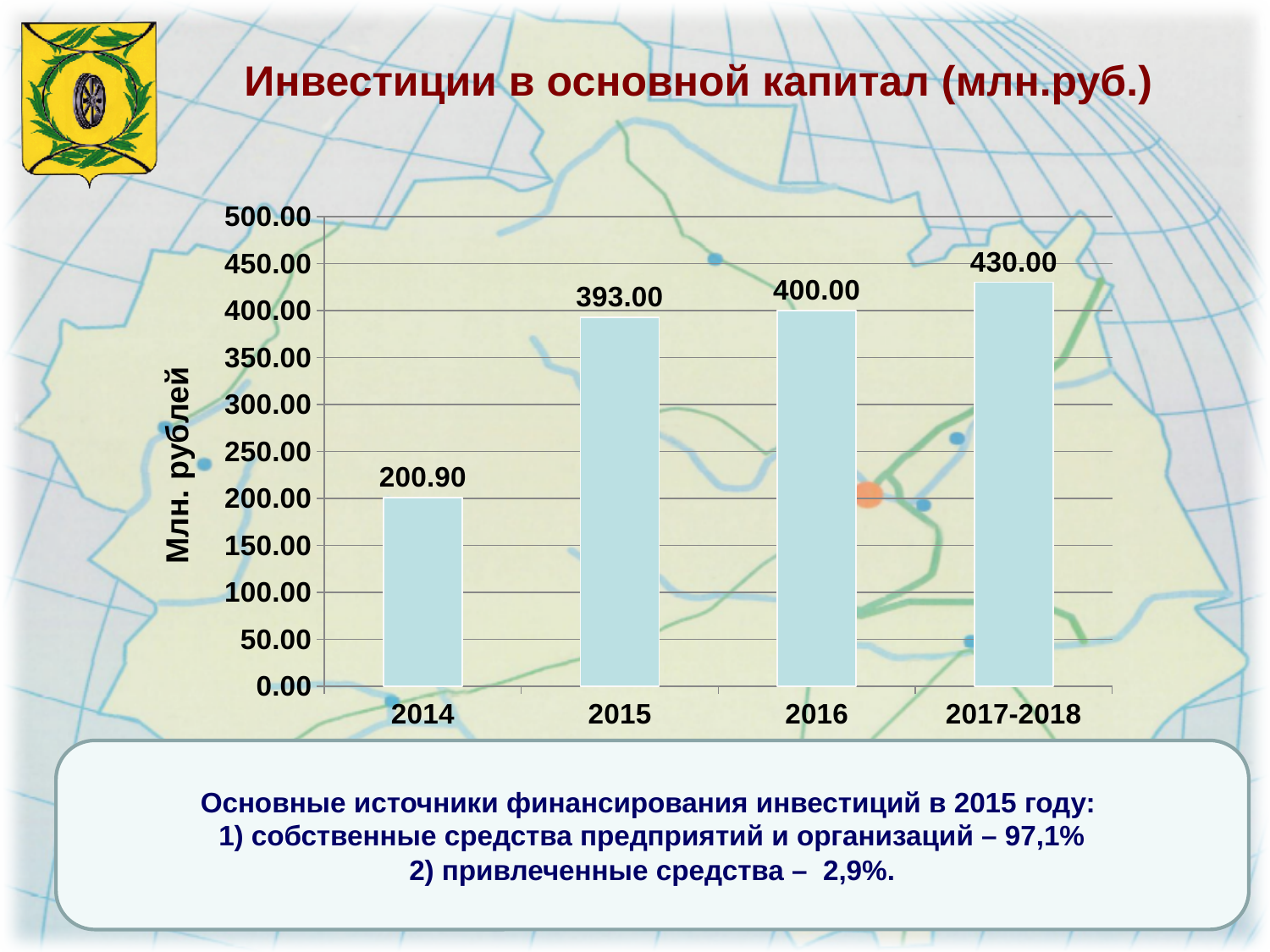
What is the value for 2017-2018? 430.00 Which category has the lowest value? 2014 What is the difference between the values for 2017-2018 and 2014? 229.10 Do the values rise or fall from 2014 to 2017-2018? rise What is the value for 2016? 400.00 Which is larger, the value for 2015 or the value for 2014? 2015 How many categories are shown on the x axis? 4 What is the difference between the values for 2016 and 2015? 7.00 What is the value for 2015? 393.00 Which category has the highest value? 2017-2018 What kind of chart is shown on the slide? bar chart What is the value for 2014? 200.90